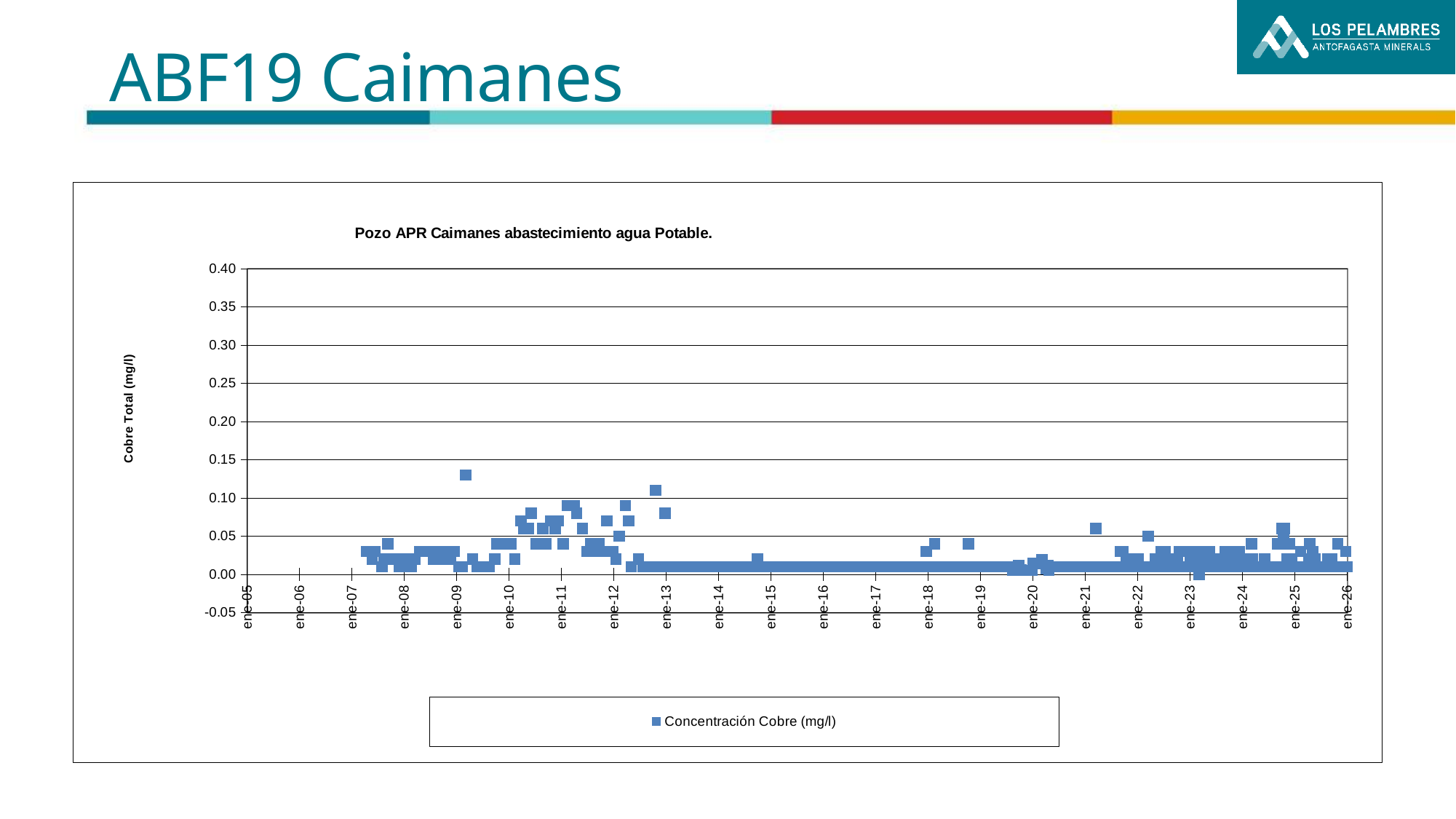
What is the label of the vertical axis? Cobre Total (mg/l) Is the highest plotted point (near ene-09) greater or less than 0.15? less What is the title of the chart? Pozo APR Caimanes abastecimiento agua Potable. How many series does the legend list? 1 What is the first label on the horizontal axis? ene-05 What kind of chart is shown on the slide? scatter chart What is the highest value shown on the vertical axis? 0.40 What is the last label on the horizontal axis? ene-26 What is the name of the series shown in the legend? Concentración Cobre (mg/l) Is the highest plotted point (near ene-09) greater or less than 0.10? greater Are all plotted points between ene-14 and ene-17 greater or less than 0.05? less What is the lowest value shown on the vertical axis? -0.05